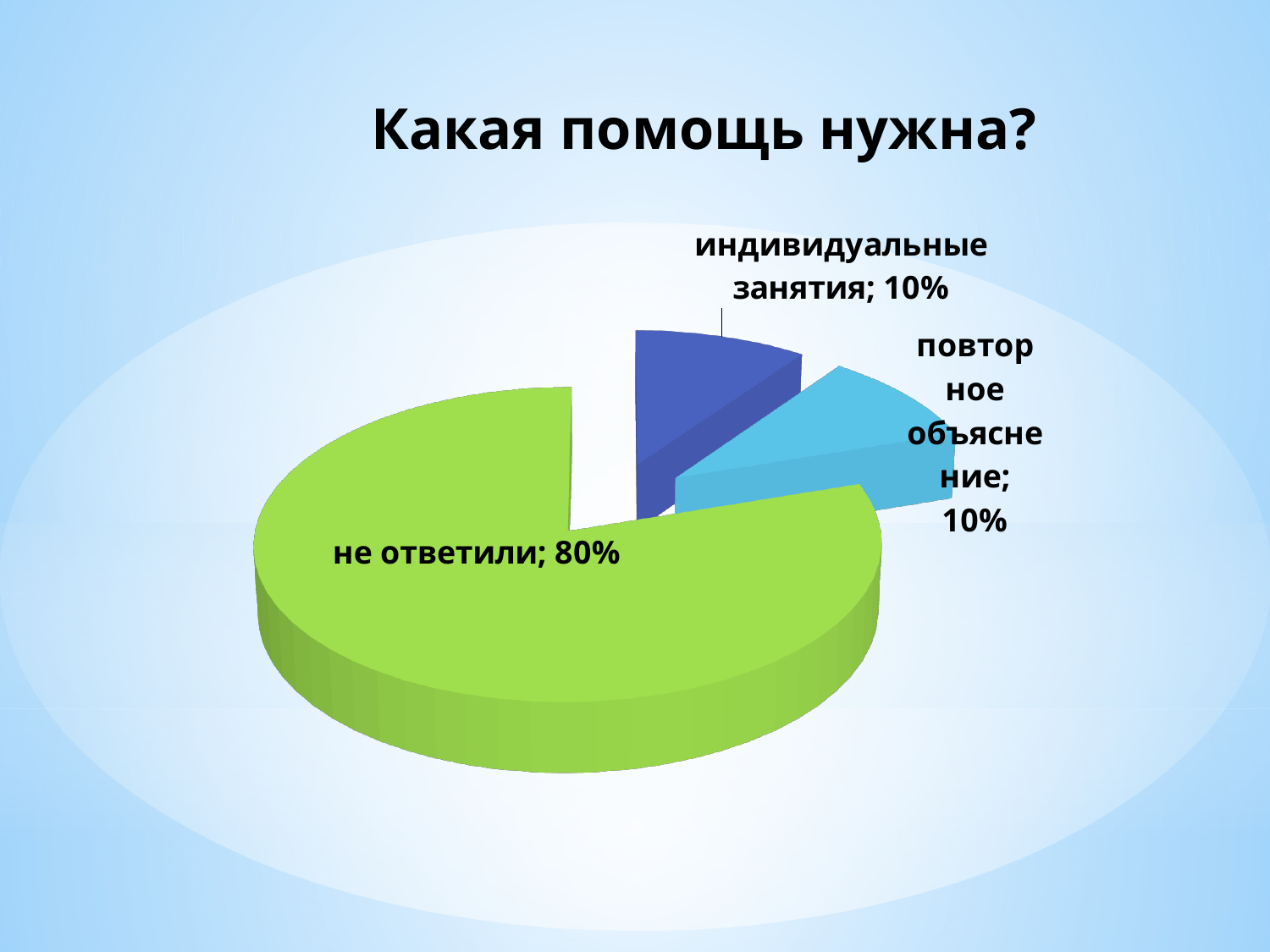
Which category has the largest slice of the pie? не ответили What is the difference between the share for "не ответили" and the share for "индивидуальные занятия"? 70% What kind of chart is shown on the slide? pie chart What is the title of the chart? Какая помощь нужна? What share of the pie is labelled "повторное объяснение"? 10% What colour is the slice for "не ответили"? green How many slices does the pie chart have? 3 What is the combined share of "индивидуальные занятия" and "повторное объяснение"? 20% Which is larger, the share for "не ответили" or the share for "повторное объяснение"? не ответили What share of the pie is labelled "индивидуальные занятия"? 10% What share of the pie is labelled "не ответили"? 80%